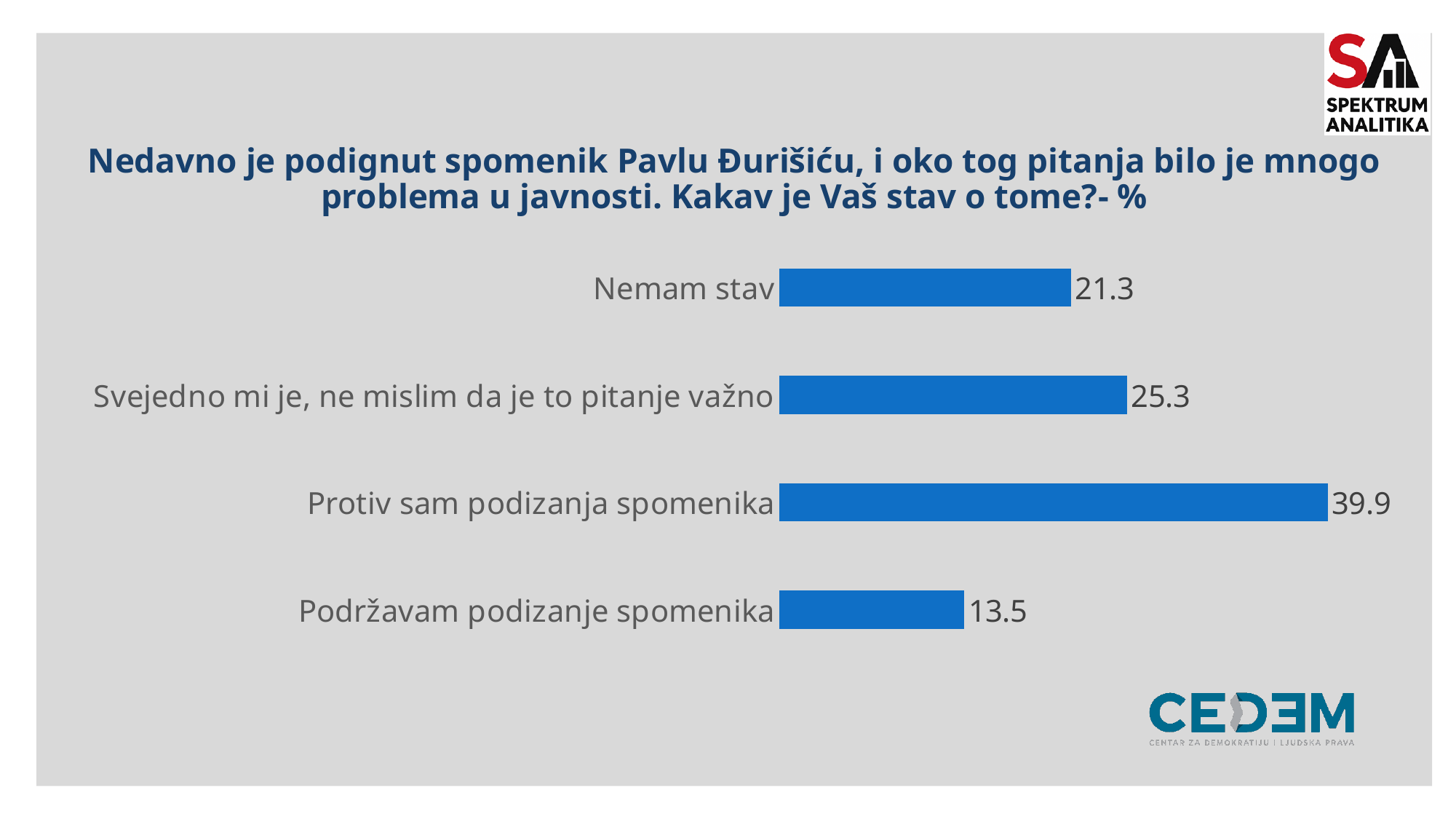
What is the difference between the values for "Protiv sam podizanja spomenika" and "Podržavam podizanje spomenika"? 26.4 What is the value for "Svejedno mi je, ne mislim da je to pitanje važno"? 25.3 How many categories are shown in the chart? 4 Which category has the lowest value? Podržavam podizanje spomenika Which is larger, the value for "Nemam stav" or the value for "Svejedno mi je, ne mislim da je to pitanje važno"? Svejedno mi je, ne mislim da je to pitanje važno What kind of chart is shown on the slide? Bar chart Which category has the highest value? Protiv sam podizanja spomenika What is the value for "Protiv sam podizanja spomenika"? 39.9 What is the value for "Nemam stav"? 21.3 What is the value for "Podržavam podizanje spomenika"? 13.5 What is the difference between the values for "Svejedno mi je, ne mislim da je to pitanje važno" and "Nemam stav"? 4.0 What colour are the bars in the chart? Blue